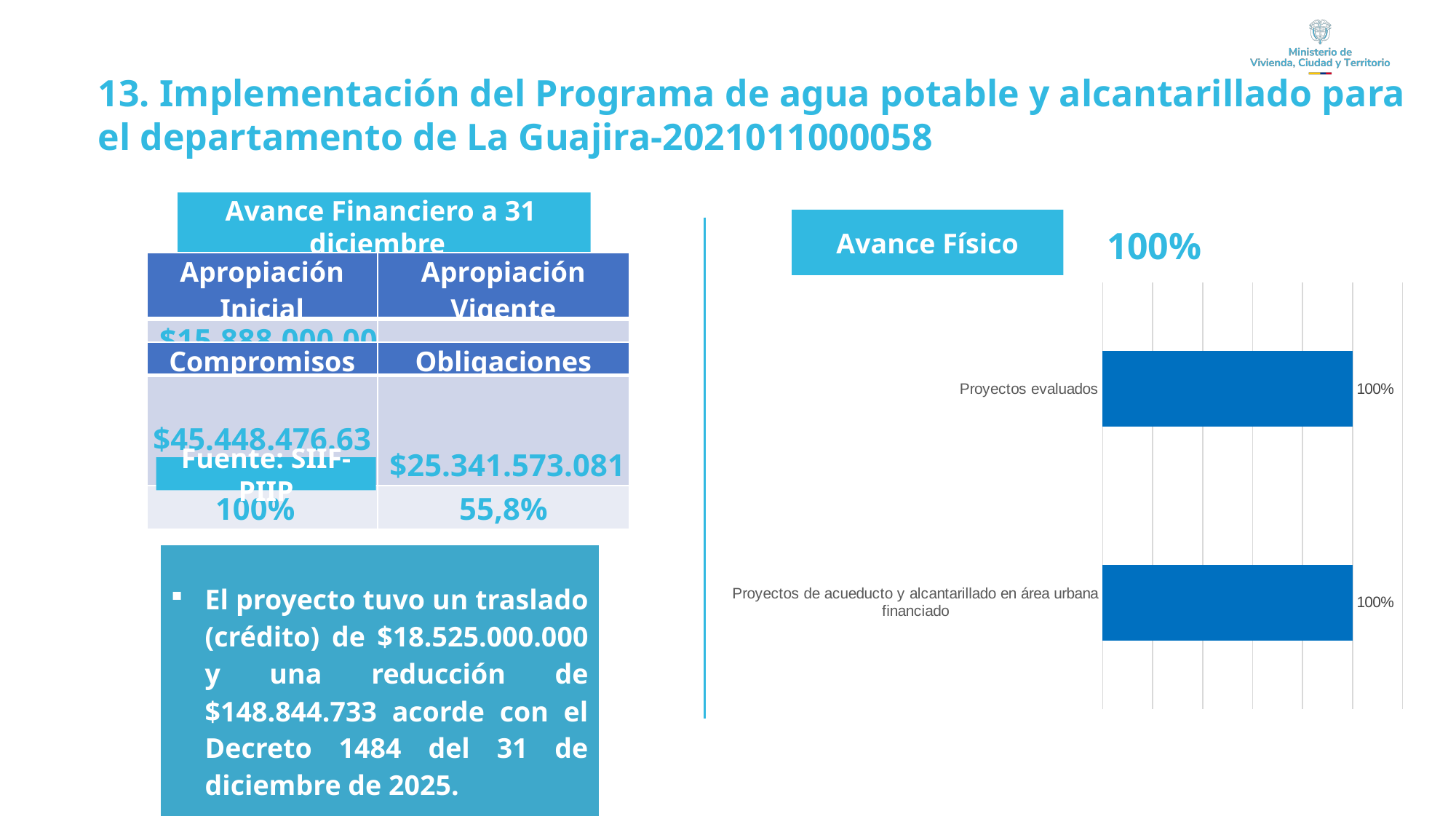
What colour are the bars in the Avance Físico chart? Blue What is the difference between the values for Proyectos evaluados and Proyectos de acueducto y alcantarillado en área urbana financiado in the Avance Físico chart? 0% What is the value for Proyectos de acueducto y alcantarillado en área urbana financiado in the Avance Físico chart? 100% Do the two bars in the Avance Físico chart have the same value? Yes What is the value for Proyectos evaluados in the Avance Físico chart? 100% How many categories are plotted in the Avance Físico chart? 2 What kind of chart is the Avance Físico chart? Bar chart Are the bars in the Avance Físico chart horizontal or vertical? Horizontal